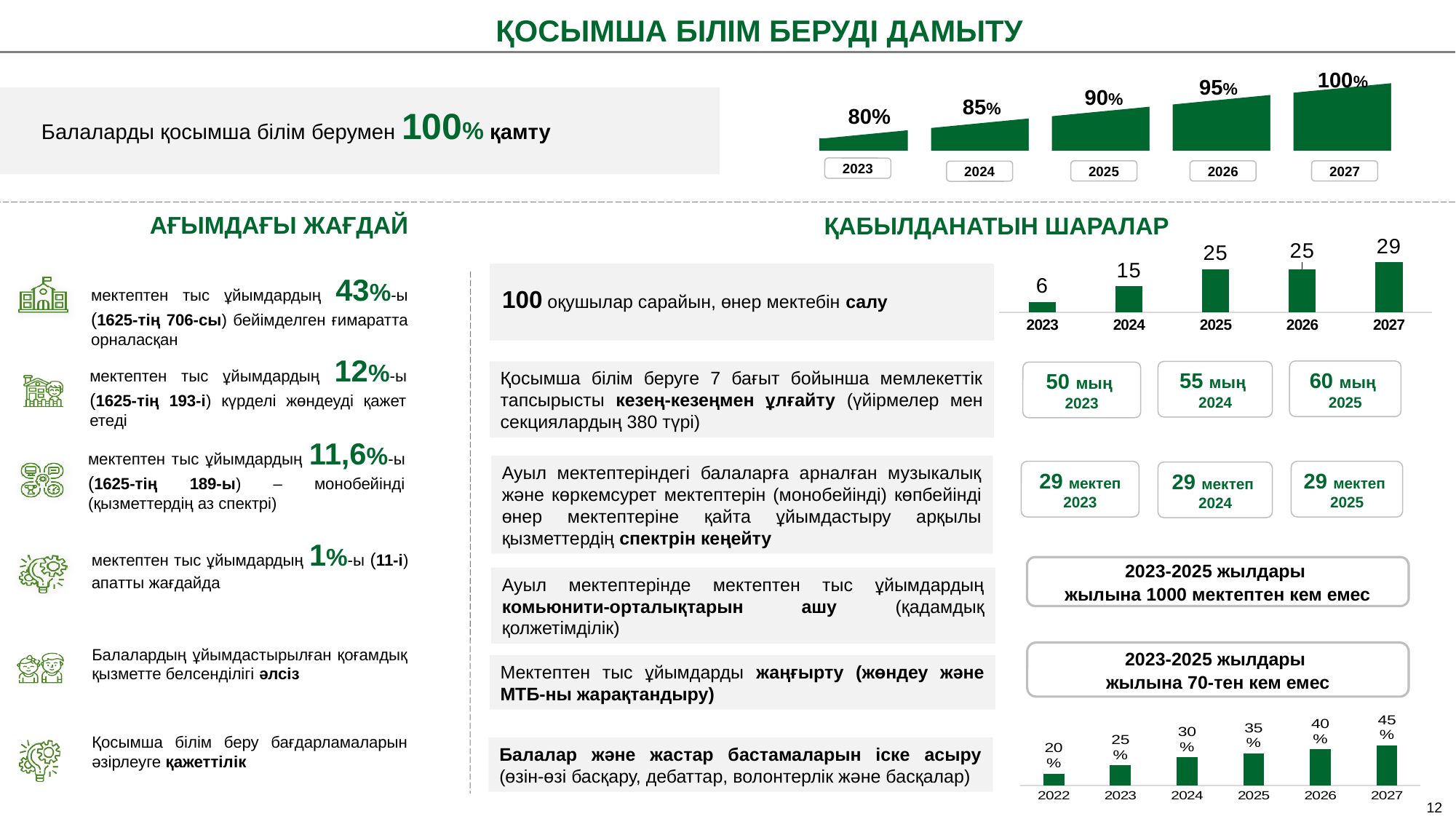
In the bar chart at the bottom right of the slide (20% to 45%), what is the difference between the values for 2027 and 2022? 25% In the bar chart at the top right of the slide (80% to 100%), do the values rise or fall from 2023 to 2027? rise In the bar chart at the top right of the slide (80% to 100%), how many years are shown? 5 What kind of chart is shown at the bottom right of the slide (20% to 45%)? bar chart In the bar chart at the top right of the slide (80% to 100%), what is the value for 2025? 90% In the bar chart at the bottom right of the slide (20% to 45%), what is the value for 2022? 20% In the bar chart on the right side of the slide below the heading ҚАБЫЛДАНАТЫН ШАРАЛАР (values 6 to 29), what is the value for 2024? 15 In the bar chart on the right side of the slide below the heading ҚАБЫЛДАНАТЫН ШАРАЛАР (values 6 to 29), what is the difference between the values for 2027 and 2023? 23 In the bar chart on the right side of the slide below the heading ҚАБЫЛДАНАТЫН ШАРАЛАР (values 6 to 29), which year has the lowest value? 2023 In the bar chart on the right side of the slide below the heading ҚАБЫЛДАНАТЫН ШАРАЛАР (values 6 to 29), which is larger, the value for 2025 or the value for 2024? 2025 In the bar chart at the top right of the slide (80% to 100%), which year has the highest value? 2027 In the bar chart at the bottom right of the slide (20% to 45%), how many years are shown? 6